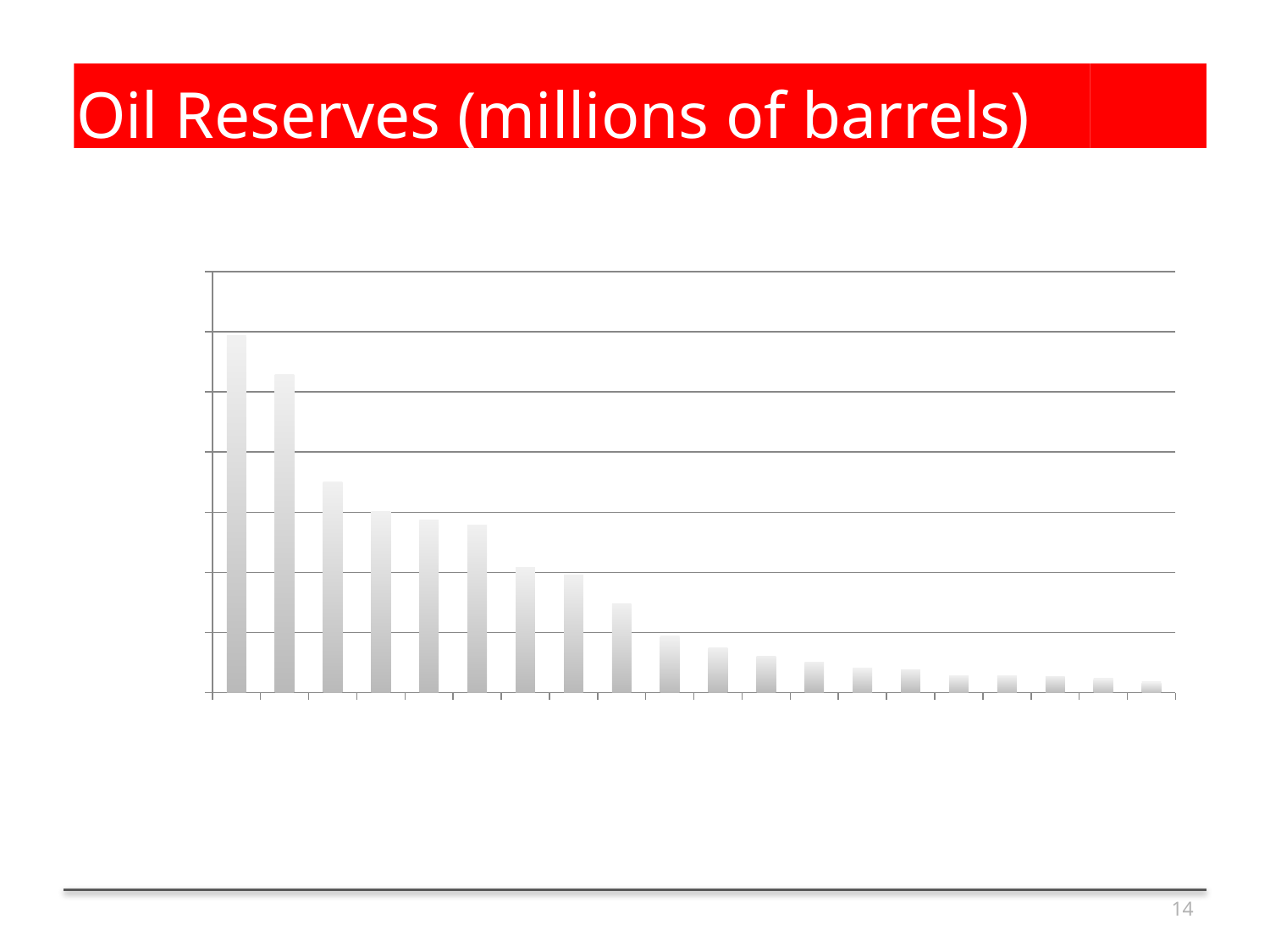
Do the bar values rise or fall from left to right along the x axis? fall Which is larger, the third bar or the fourth bar? the third bar How many bars are plotted in the chart? 20 Which is larger, the first bar or the second bar? the first bar What unit does the slide title say the oil reserves are measured in? millions of barrels What is the title shown above the chart on the slide? Oil Reserves (millions of barrels) Which bar is the tallest in the chart? the first (leftmost) bar What kind of chart is shown on the slide? bar chart Which bar is the shortest in the chart? the last (rightmost) bar